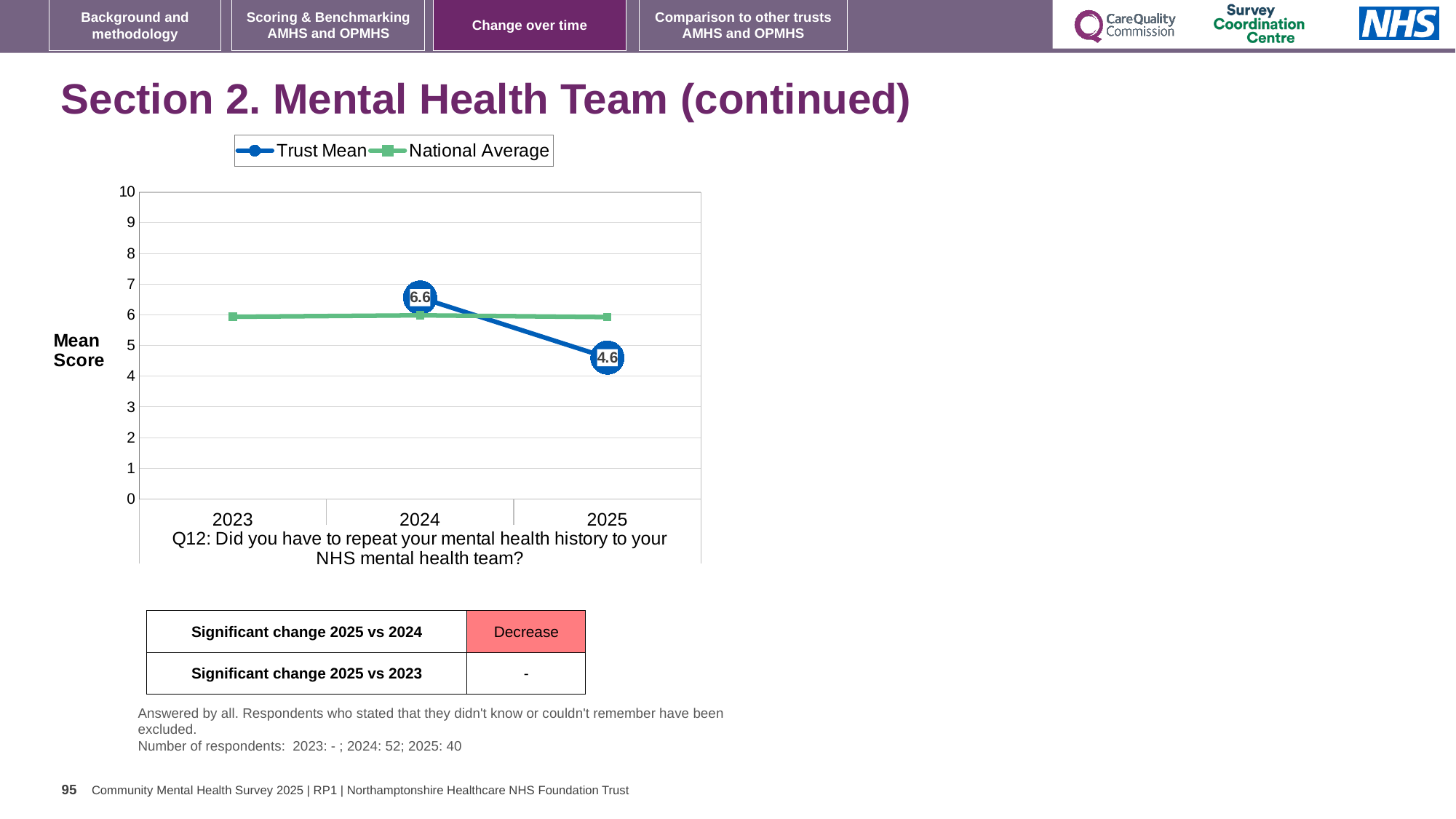
How many series does the legend list? 2 What is the Trust Mean value for 2025? 4.6 In 2024, which is larger: the Trust Mean or the National Average? Trust Mean Is the National Average value for 2023 greater or less than 5? greater How many years are shown on the x axis? 3 What kind of chart is shown on the slide? line chart In 2025, which is larger: the Trust Mean or the National Average? National Average Does the Trust Mean rise or fall from 2024 to 2025? fall What is the label of the y axis? Mean Score Is the National Average value for 2025 greater or less than 7? less What is the Trust Mean value for 2024? 6.6 By how much did the Trust Mean change from 2024 to 2025? 2.0